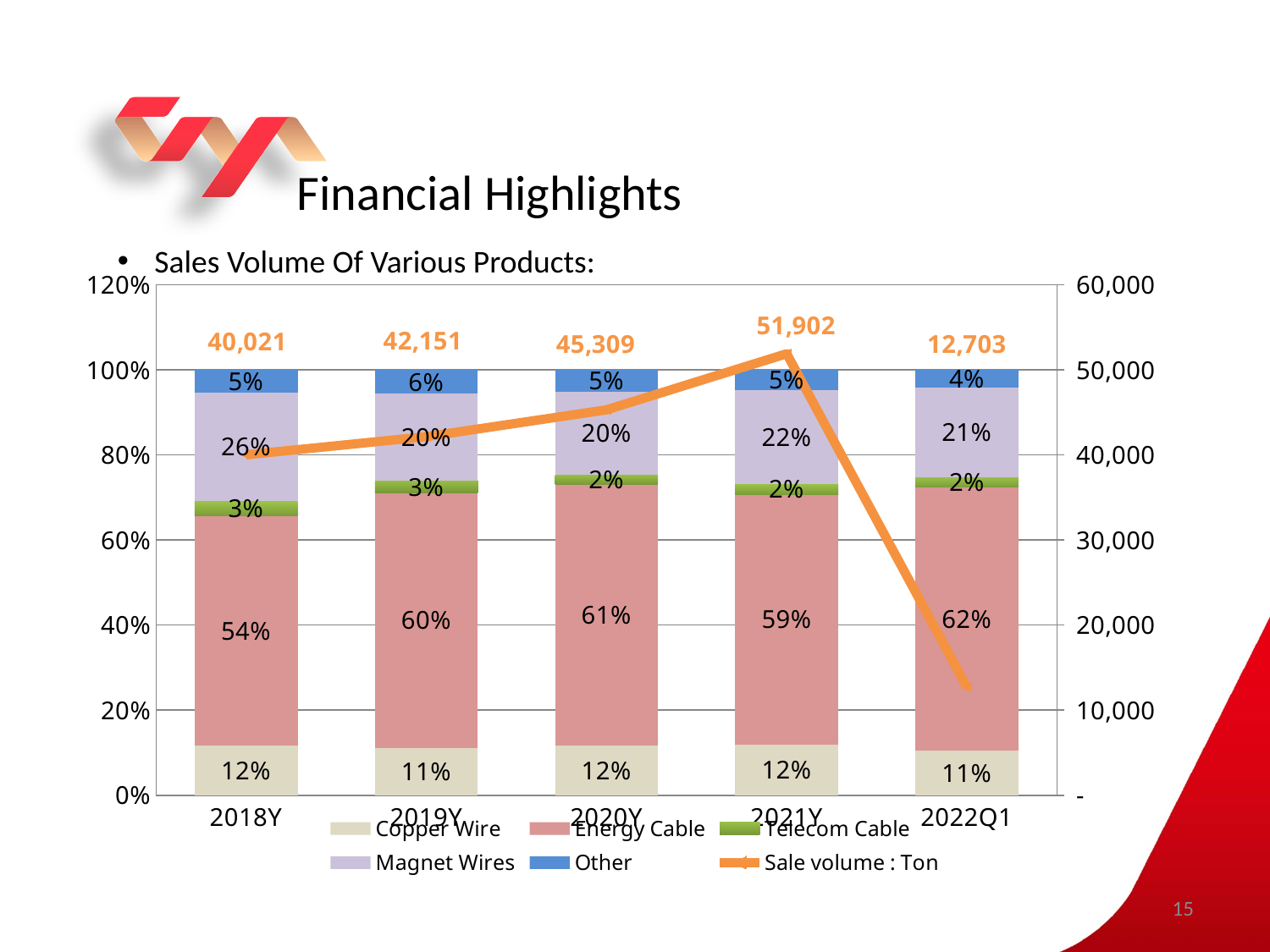
Which period has the lowest sale volume in tons? 2022Q1 Does the sale volume in tons rise or fall from 2018Y to 2021Y? rise How many series does the legend list? 6 What kind of chart is used to show the product shares? Stacked bar chart with a line overlay What is the sale volume in tons for 2021Y? 51,902 Which is larger, the Energy Cable share in 2019Y or in 2022Q1? 2022Q1 Which period has the highest sale volume in tons? 2021Y What share of sales volume does Energy Cable account for in 2018Y? 54% What percentage does Magnet Wires represent in 2022Q1? 21% Is the sale volume for 2019Y greater or less than 40,000 tons? greater How many periods are shown on the x axis? 5 What is the difference in sale volume (tons) between 2021Y and 2020Y? 6,593